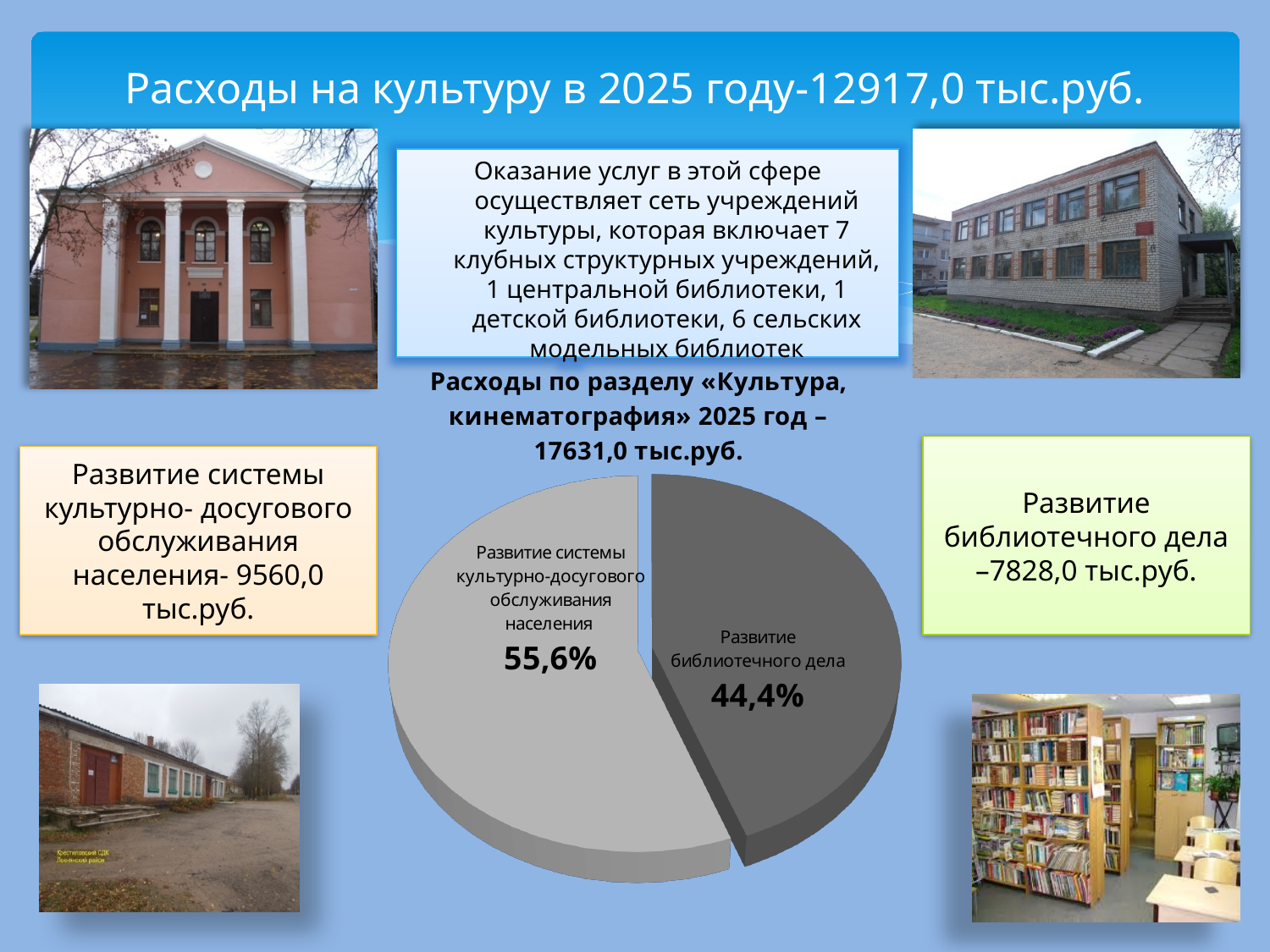
What is the total of the two shares shown in the pie chart? 100% By how many percentage points does the share of «Развитие системы культурно-досугового обслуживания населения» exceed that of «Развитие библиотечного дела»? 11,2 How many slices does the pie chart have? 2 What colour is the slice for «Развитие библиотечного дела» in the pie chart? Dark grey Which slice of the pie chart is the largest? Развитие системы культурно-досугового обслуживания населения Is the share of «Развитие библиотечного дела» greater or less than 50%? less What share of the pie chart does «Развитие системы культурно-досугового обслуживания населения» take? 55,6% Which slice of the pie chart is the smallest? Развитие библиотечного дела Which is larger in the pie chart: the share of «Развитие библиотечного дела» or the share of «Развитие системы культурно-досугового обслуживания населения»? Развитие системы культурно-досугового обслуживания населения What share of the pie chart does «Развитие библиотечного дела» take? 44,4% What is the title of the pie chart? Расходы по разделу «Культура, кинематография» 2025 год – 17631,0 тыс.руб. What kind of chart is shown on the slide? Pie chart